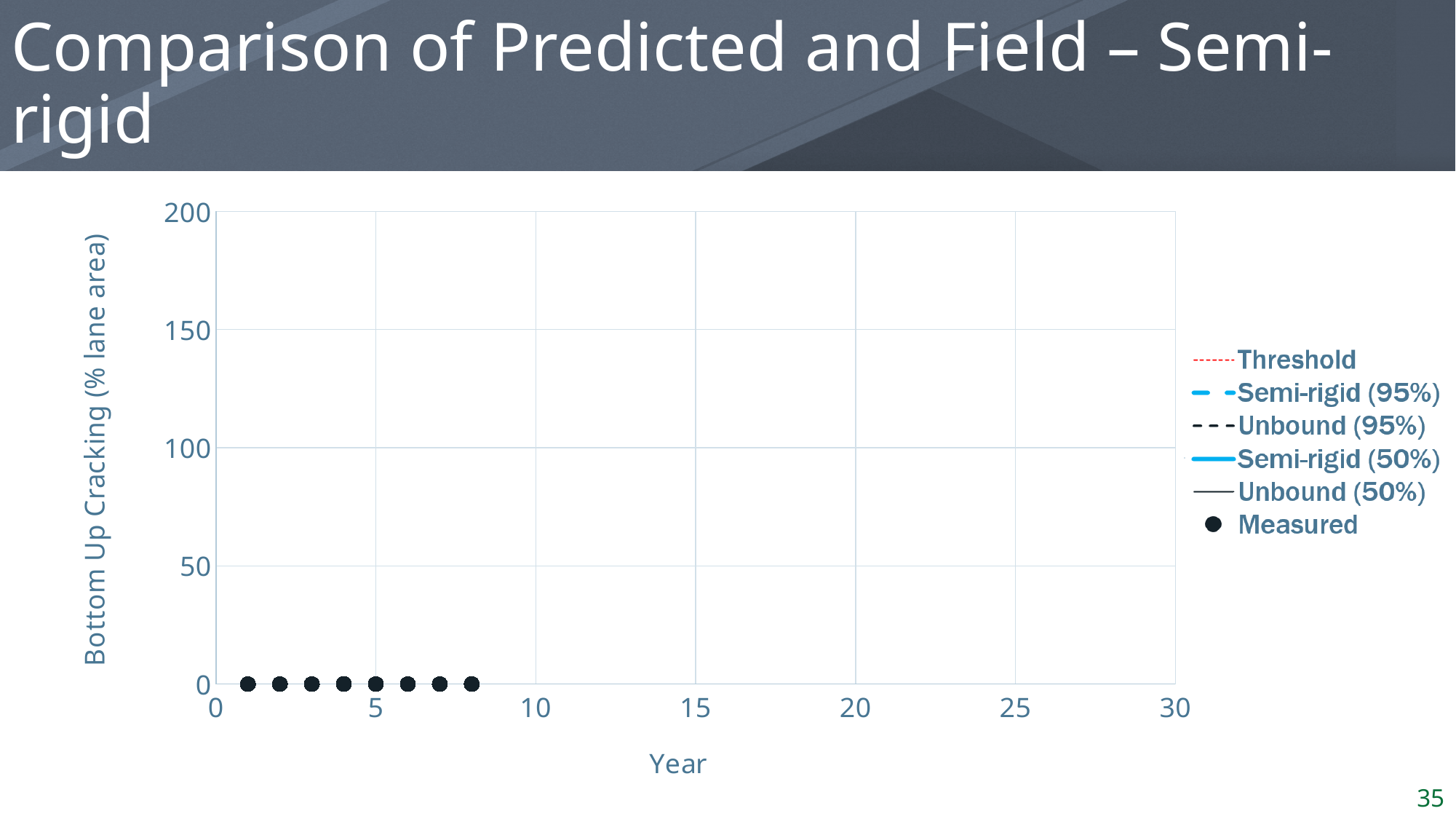
What is the maximum value shown on the y axis? 200 Do the Measured values rise, fall, or stay flat from year 1 to year 8? stay flat How many Measured data points are plotted on the chart? 8 What is the label of the y axis? Bottom Up Cracking (% lane area) Is the Measured value at year 8 greater or less than 100? less Is the Measured value at year 5 greater or less than 50? less What is the label of the x axis? Year What kind of chart is shown on the slide? scatter chart How many series does the legend list? 6